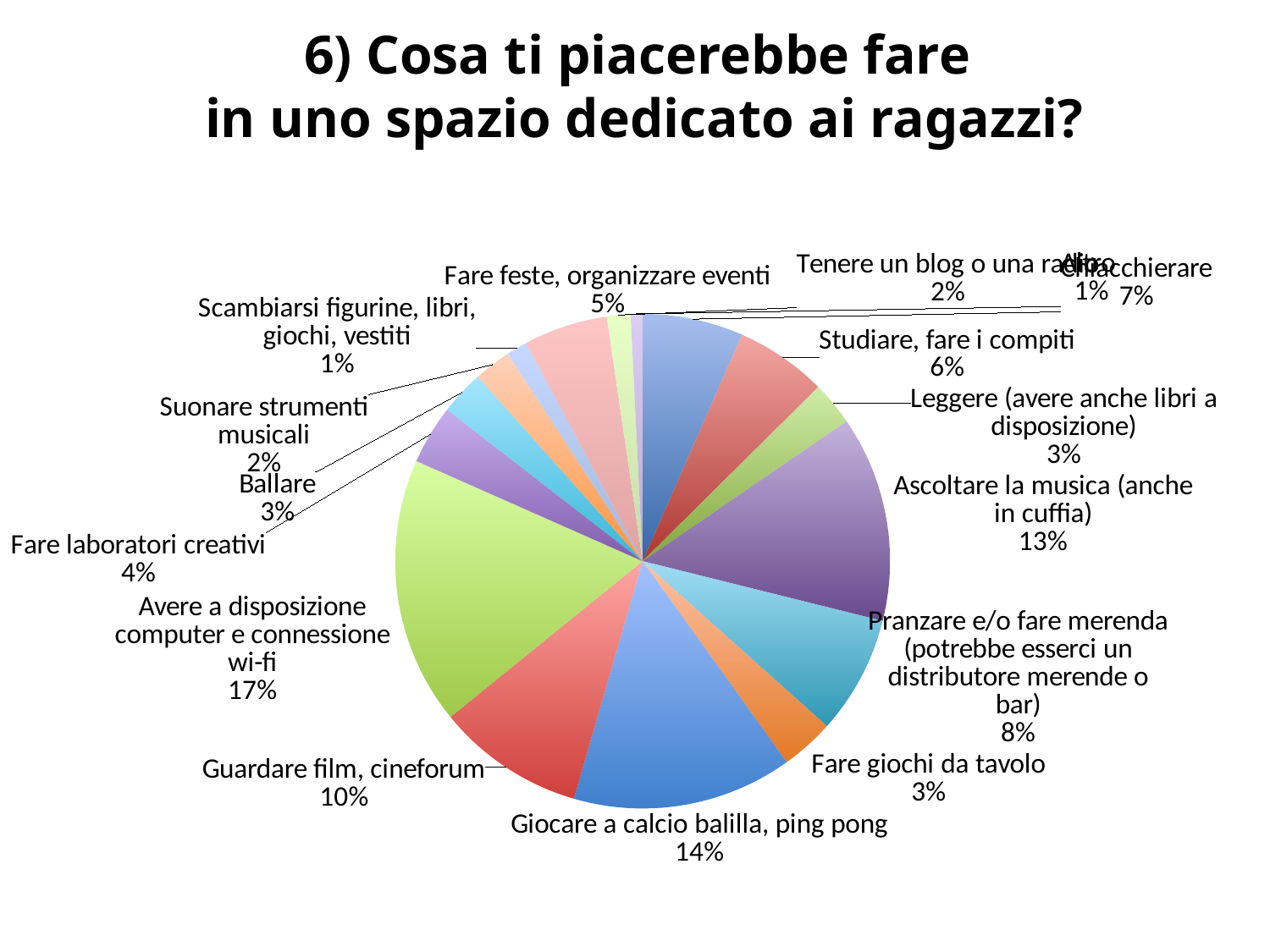
What is the difference in percentage points between 'Avere a disposizione computer e connessione wi-fi' and 'Giocare a calcio balilla, ping pong'? 3 How many slices does the pie chart have? 16 What is the difference in percentage points between 'Ascoltare la musica (anche in cuffia)' and 'Fare laboratori creativi'? 9 What is the value shown for 'Fare feste, organizzare eventi'? 5% What kind of chart is shown on the slide? pie chart Which is larger: 'Studiare, fare i compiti' or 'Pranzare e/o fare merenda'? Pranzare e/o fare merenda What is the value shown for 'Chiacchierare'? 7% Which category has the largest share of the pie? Avere a disposizione computer e connessione wi-fi What is the value shown for 'Guardare film, cineforum'? 10% What is the title of the slide? 6) Cosa ti piacerebbe fare in uno spazio dedicato ai ragazzi? What percentage of the pie is 'Ascoltare la musica (anche in cuffia)'? 13% What is the value shown for 'Giocare a calcio balilla, ping pong'? 14%